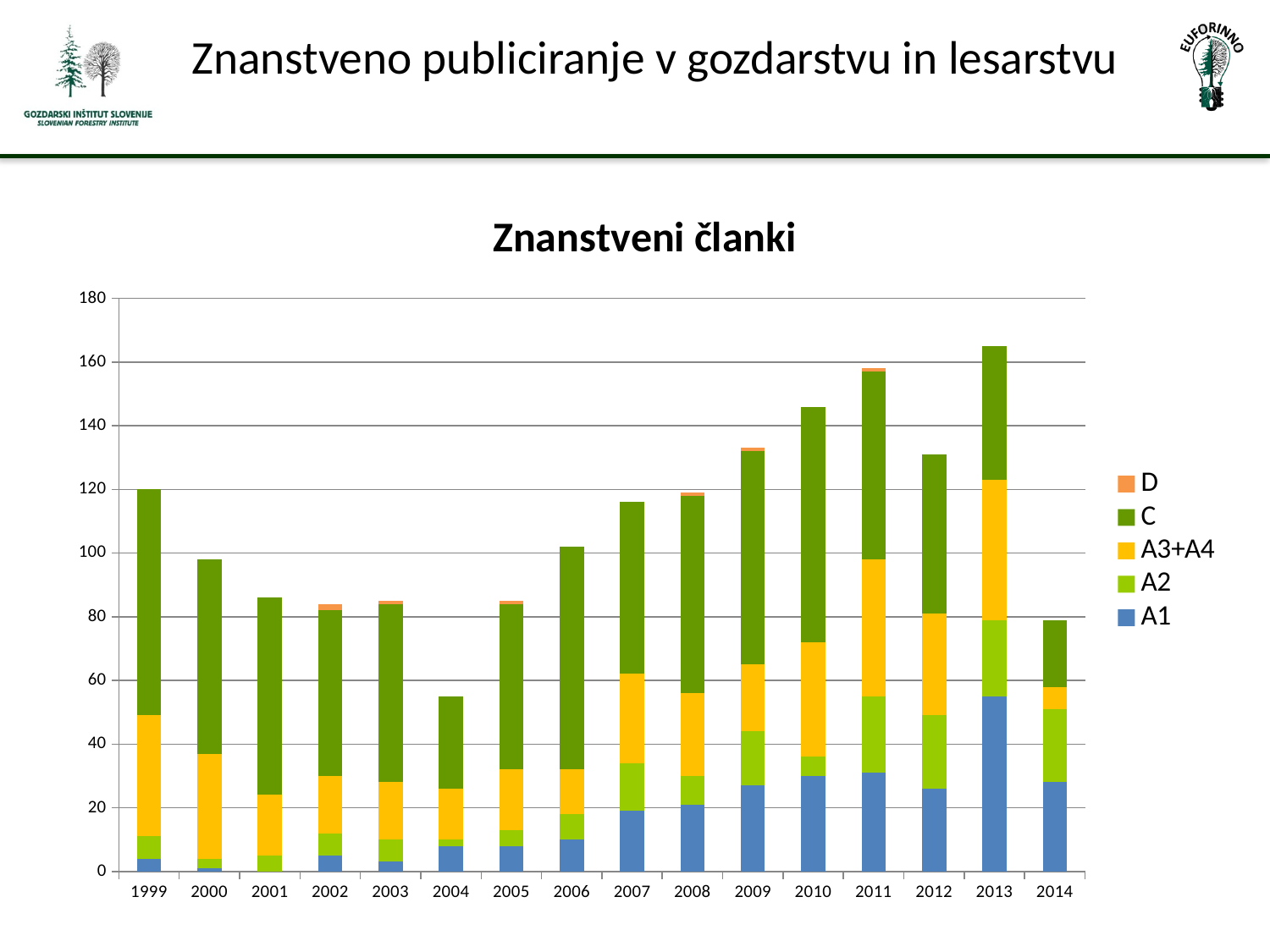
Do the total bar heights rise or fall from 2004 to 2011? rise Which year has the shortest stacked bar? 2004 How many years are shown on the x axis? 16 Is the total bar height for 2014 greater or less than 100? less How many series does the legend list? 5 Is the total bar height for 2004 greater or less than 60? less Which year has the taller stacked bar, 2010 or 2012? 2010 What kind of chart is shown on the slide? Stacked bar chart What is the title of the chart? Znanstveni članki Is the total bar height for 2010 greater or less than 140? greater Which year has the tallest stacked bar? 2013 Which legend entry is shown in blue? A1